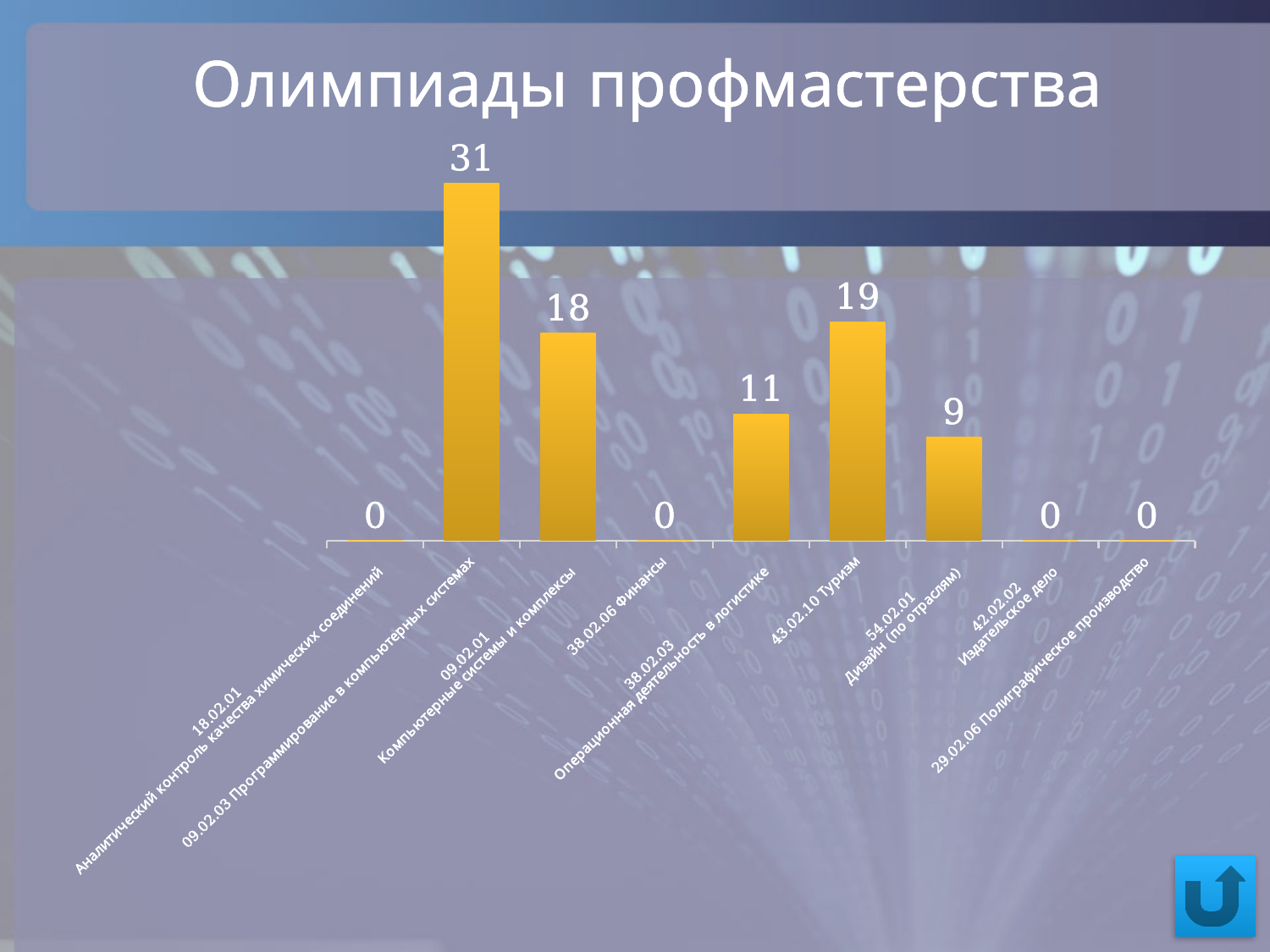
How many categories have a value of 0? 4 What is the value for 54.02.01 Дизайн (по отраслям)? 9 How many categories are shown on the x axis? 9 What is the value for 09.02.03 Программирование в компьютерных системах? 31 What is the value for 38.02.06 Финансы? 0 What kind of chart is shown on the slide? Bar chart What is the title of the slide? Олимпиады профмастерства What is the value for 43.02.10 Туризм? 19 Which category has the highest value? 09.02.03 Программирование в компьютерных системах What is the difference between the values for 09.02.03 Программирование в компьютерных системах and 09.02.01 Компьютерные системы и комплексы? 13 What is the difference between the values for 43.02.10 Туризм and 38.02.03 Операционная деятельность в логистике? 8 Which is larger, the value for 43.02.10 Туризм or the value for 09.02.01 Компьютерные системы и комплексы? 43.02.10 Туризм